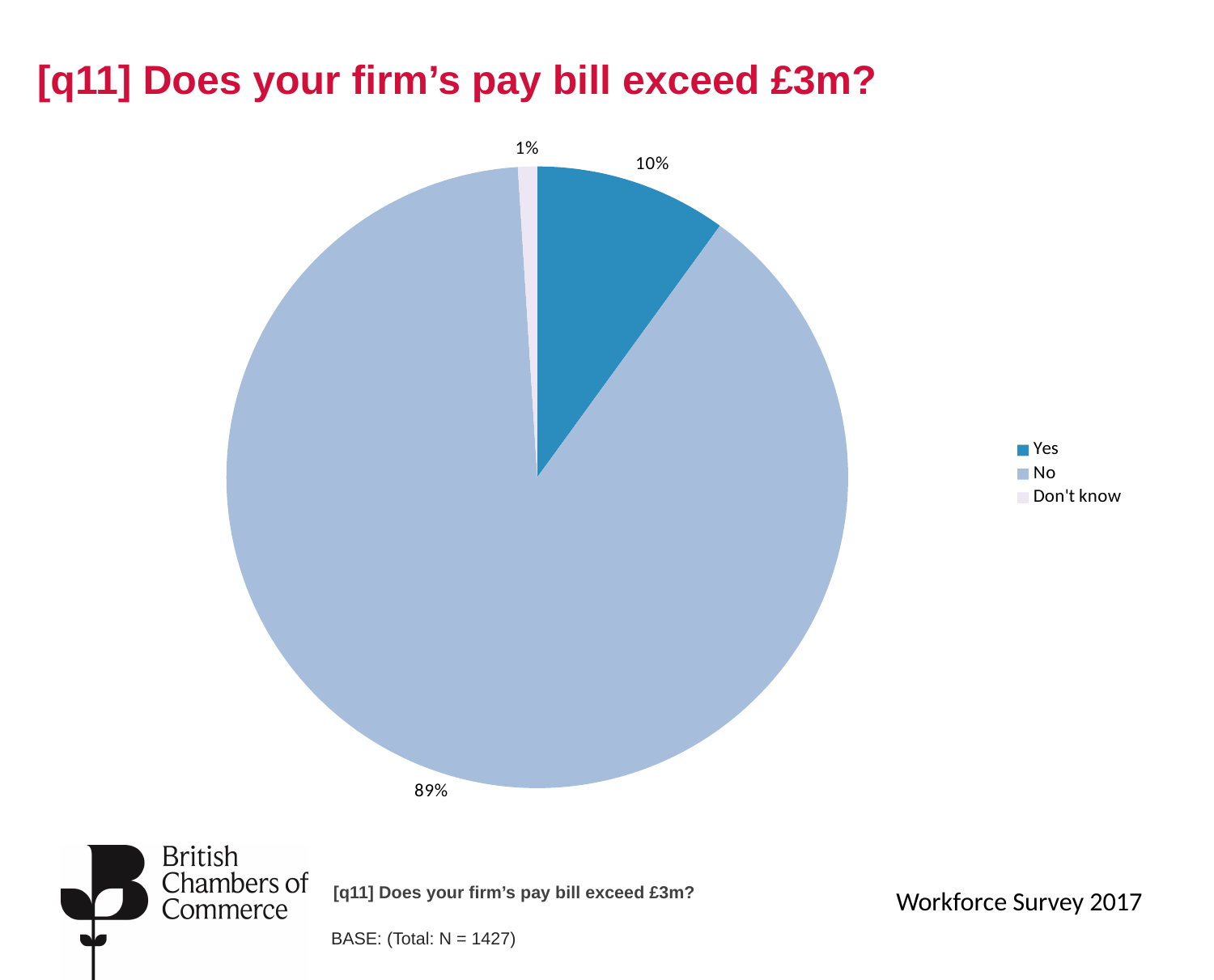
What is the base sample size stated on the slide? N = 1427 What is the difference in percentage points between the No and Yes shares? 79 How many entries does the legend list? 3 What percentage of firms answered Yes to whether their pay bill exceeds £3m? 10% Which response has the smallest share of the pie? Don't know What percentage of firms answered Don't know? 1% Which response has the largest share of the pie? No Which is larger, the share for Yes or the share for Don't know? Yes Which legend entry is shown in the darkest blue colour? Yes What kind of chart is shown on the slide? Pie chart What percentage of firms answered No? 89% How many slices does the pie chart have? 3